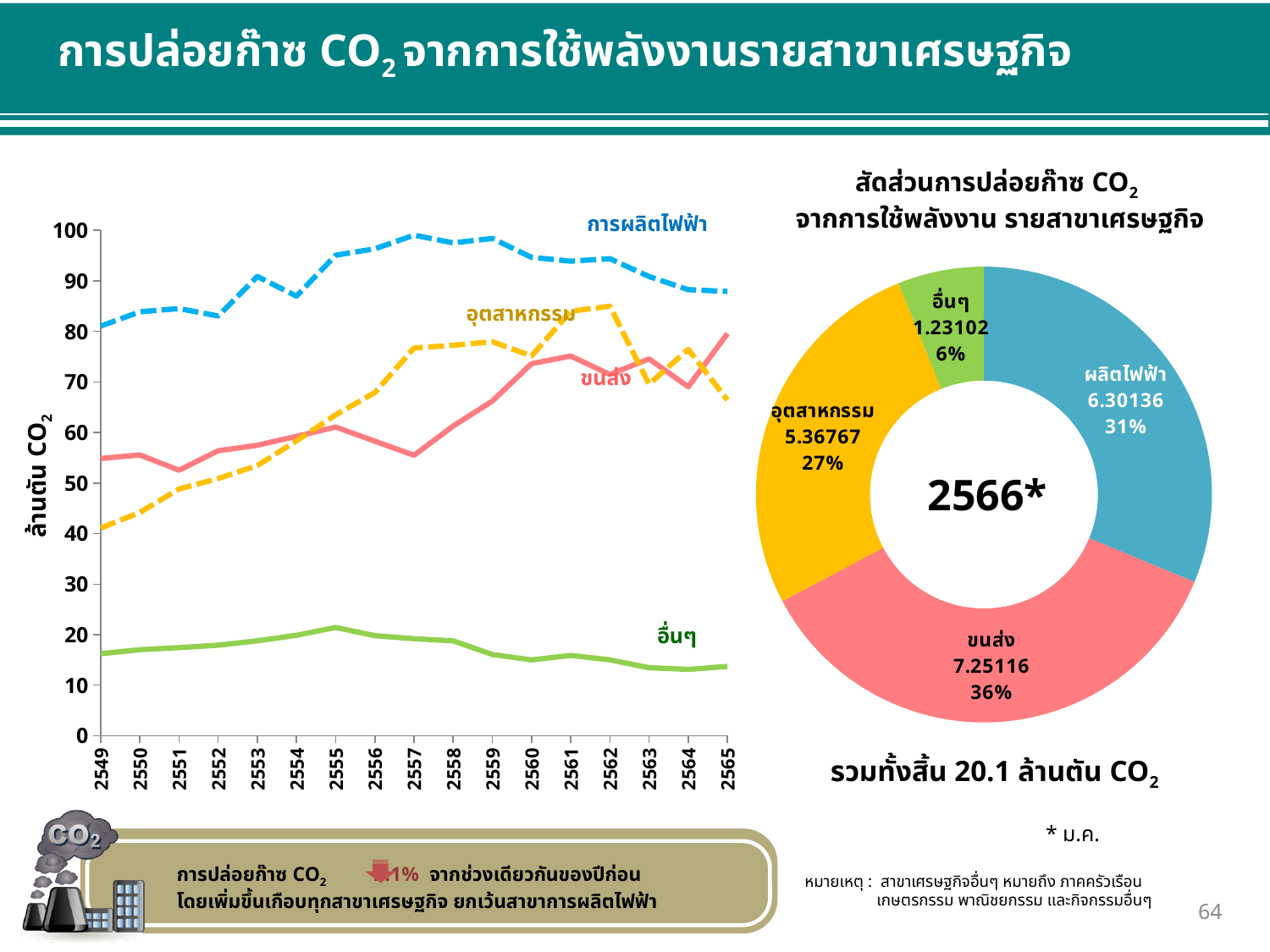
In the line chart on the left, is the value for การผลิตไฟฟ้า in 2557 greater or less than 90? greater In the donut chart on the right, which sector has the smallest share? อื่นๆ In the donut chart on the right, what percentage share does ขนส่ง have? 36% In the line chart on the left, how many years are shown on the x axis? 17 In the donut chart on the right, which sector has the largest share? ขนส่ง In the donut chart on the right, what total is stated below the chart? 20.1 ล้านตัน CO2 In the donut chart on the right, what year is shown in the centre? 2566* What kind of chart is the chart on the left of the slide? line chart In the line chart on the left, is the value for อื่นๆ in 2565 greater or less than 20? less In the donut chart on the right, what is the value shown for ผลิตไฟฟ้า? 6.30136 In the donut chart on the right, what is the difference in percentage points between the ขนส่ง share and the อุตสาหกรรม share? 9% In the donut chart on the right, what is the value shown for อุตสาหกรรม? 5.36767